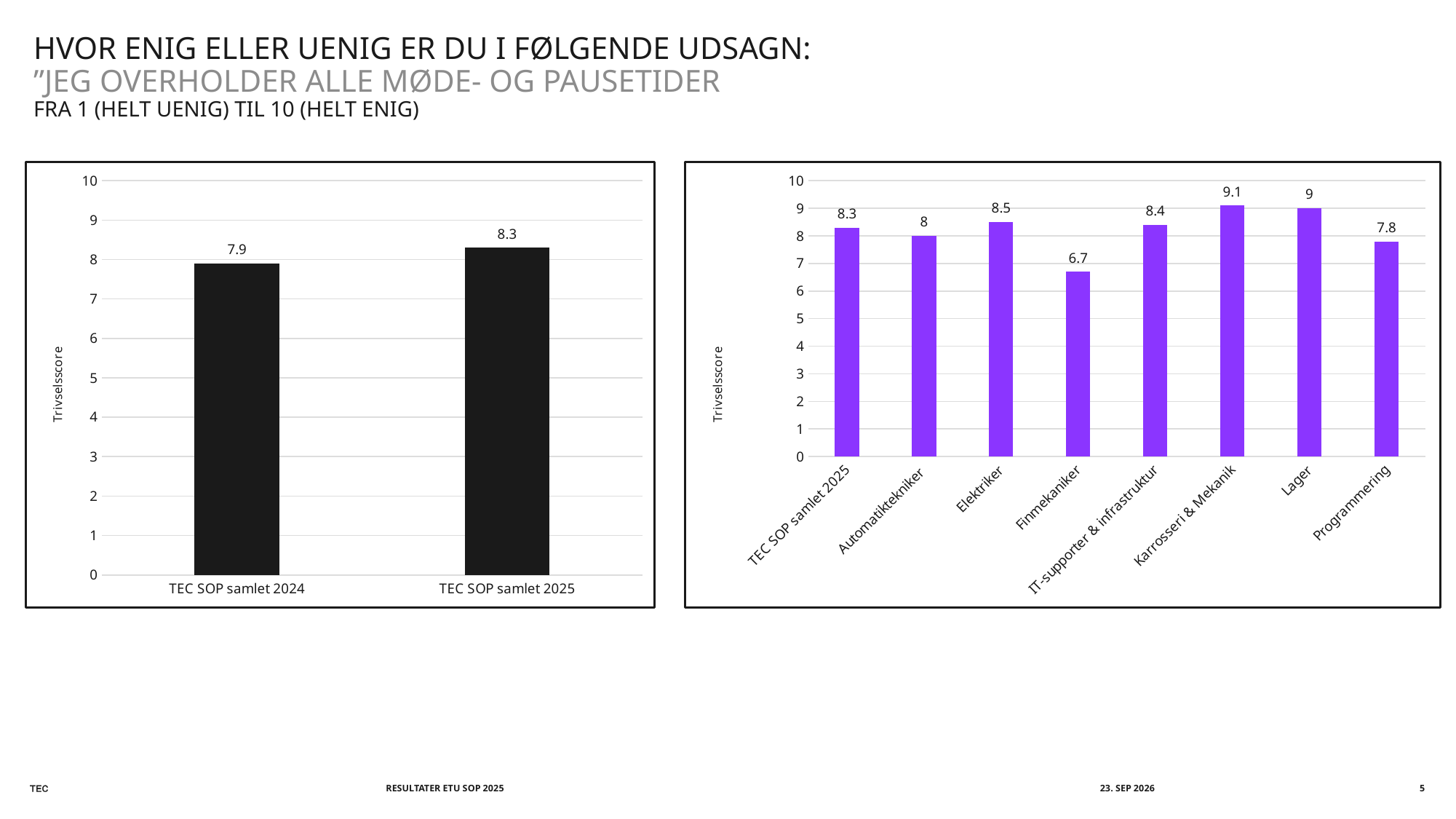
In the left chart, what is the value for TEC SOP samlet 2025? 8.3 In the left chart, what is the value for TEC SOP samlet 2024? 7.9 What kind of chart is the right chart? bar chart In the left chart, what is the difference between TEC SOP samlet 2025 and TEC SOP samlet 2024? 0.4 In the left chart, do the values rise or fall from 2024 to 2025? rise In the right chart, what is the value for Karrosseri & Mekanik? 9.1 In the right chart, what is the value for Finmekaniker? 6.7 How many categories are shown in the right chart? 8 In the right chart, what is the difference between Lager and Automatiktekniker? 1 In the right chart, which category has the highest value? Karrosseri & Mekanik In the right chart, which category has the lowest value? Finmekaniker In the right chart, which is larger, Elektriker or Programmering? Elektriker